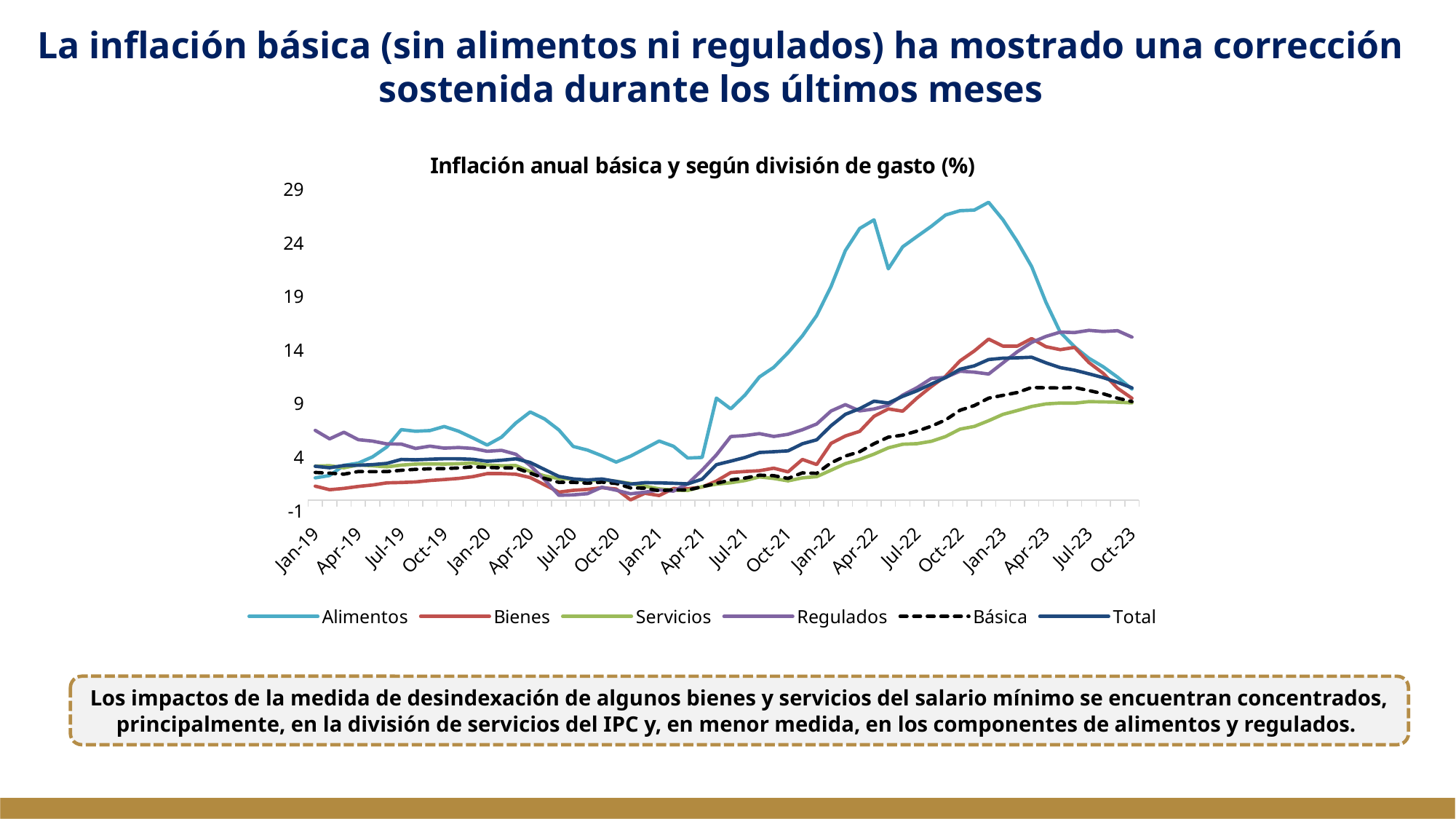
Is the value for Bienes at Jan-19 greater or less than 4? less Is the value for Regulados at Oct-23 greater or less than 14? greater Does the Alimentos series rise or fall between Jan-23 and Oct-23? fall What kind of chart is shown on the slide? line chart Is the peak value of Alimentos greater or less than 24? greater Which series reaches the highest value on the chart? Alimentos What is the title of the chart? Inflación anual básica y según división de gasto (%) Which series has the highest value at Oct-23? Regulados Which series has the lowest value at Jan-19? Bienes How many series does the legend list? 6 At Apr-22, which is larger, Alimentos or Regulados? Alimentos Which series is drawn with a dashed line? Básica